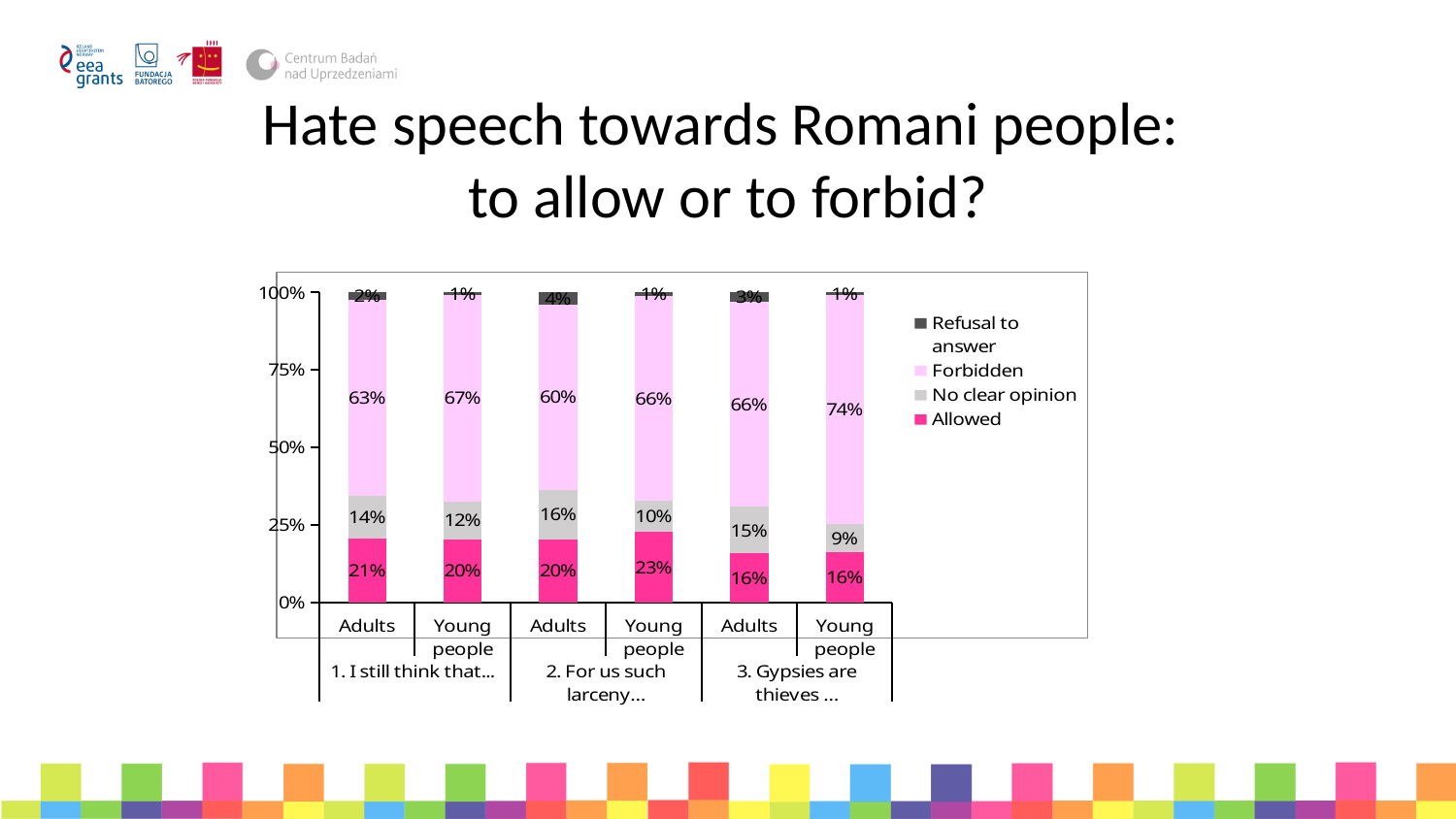
What type of chart is shown on the slide? Stacked bar chart What is the 'Refusal to answer' value for Adults under '2. For us such larceny...'? 4% What is the 'Allowed' value for Adults under '1. I still think that...'? 21% What is the difference between the 'Forbidden' values for Adults and Young people under '1. I still think that...'? 4% How many bars are plotted in the chart? 6 What is the 'No clear opinion' value for Adults under '2. For us such larceny...'? 16% Which bar has the lowest 'No clear opinion' value? Young people, 3. Gypsies are thieves ... Which bar has the highest 'Forbidden' value? Young people, 3. Gypsies are thieves ... How many series does the legend list? 4 Which series is shown in the darkest colour at the top of each bar? Refusal to answer What is the 'Forbidden' value for Young people under '3. Gypsies are thieves ...'? 74% Which is larger: the 'Allowed' value for Young people under '2. For us such larceny...' or for Adults under '3. Gypsies are thieves ...'? Young people under 2. For us such larceny... (23%)